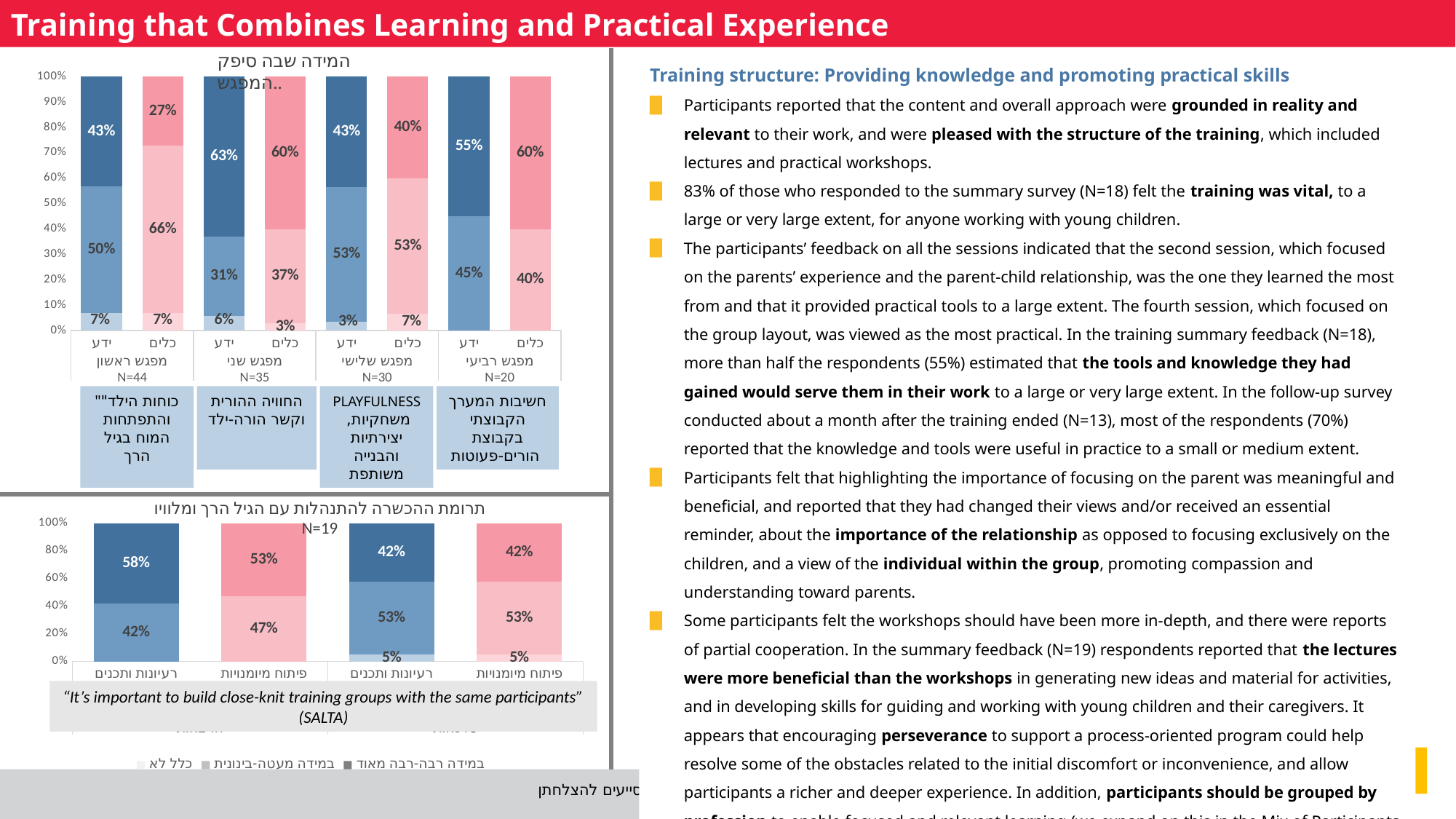
In the top chart, what is the value of the bottom segment of the ידע bar for מפגש שלישי? 3% How many series does the legend at the bottom of the slide list? 3 What kind of chart is the bottom chart (תרומת ההכשרה להתנהלות עם הגיל הרך ומלוויו)? Stacked bar chart In the top chart, is the top segment of the כלים bar larger for מפגש רביעי or for מפגש שלישי? מפגש רביעי (60% vs 40%) In the top chart, what is the difference between the top segment of the ידע bar (43%) and the top segment of the כלים bar (27%) for מפגש ראשון? 16 percentage points In the top chart, what is the value of the middle segment of the כלים bar for מפגש ראשון? 66% In the top chart, what is the value of the top segment of the ידע bar for מפגש שני? 63% In the top chart (המידה שבה סיפק המפגש), what percentage is shown for the top (dark blue) segment of the ידע bar for מפגש רביעי? 55% In the bottom chart, what is the value of the top segment of the leftmost bar (רעיונות ותכנים)? 58% In the top chart, how many sessions (מפגשים) are shown along the x axis? 4 In the top chart, which session has the highest top-segment value for the ידע bar? מפגש שני (63%) In the top chart, what is the N shown for מפגש שלישי? N=30